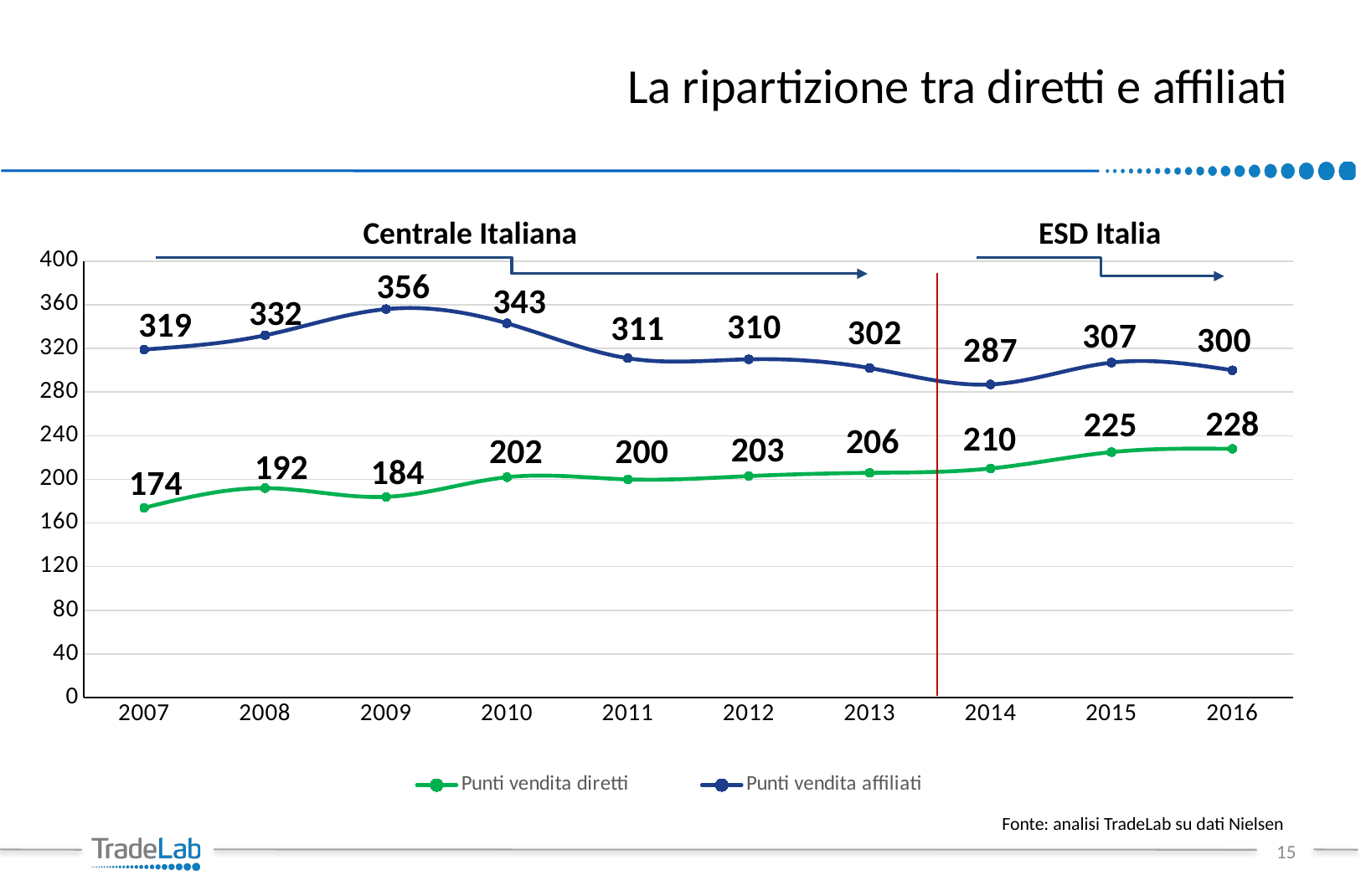
What kind of chart is shown on the slide? line chart What is the value for Punti vendita affiliati in 2009? 356 What is the value for Punti vendita diretti in 2016? 228 Which is larger in 2010: Punti vendita affiliati or Punti vendita diretti? Punti vendita affiliati What is the value for Punti vendita diretti in 2007? 174 In which year is Punti vendita affiliati highest? 2009 In which year is Punti vendita diretti lowest? 2007 What is the difference between Punti vendita affiliati and Punti vendita diretti in 2014? 77 Is the value for Punti vendita affiliati in 2014 greater or less than 320? less Does Punti vendita diretti rise or fall from 2013 to 2016? rise How many years are shown on the x axis? 10 How many series does the legend list? 2